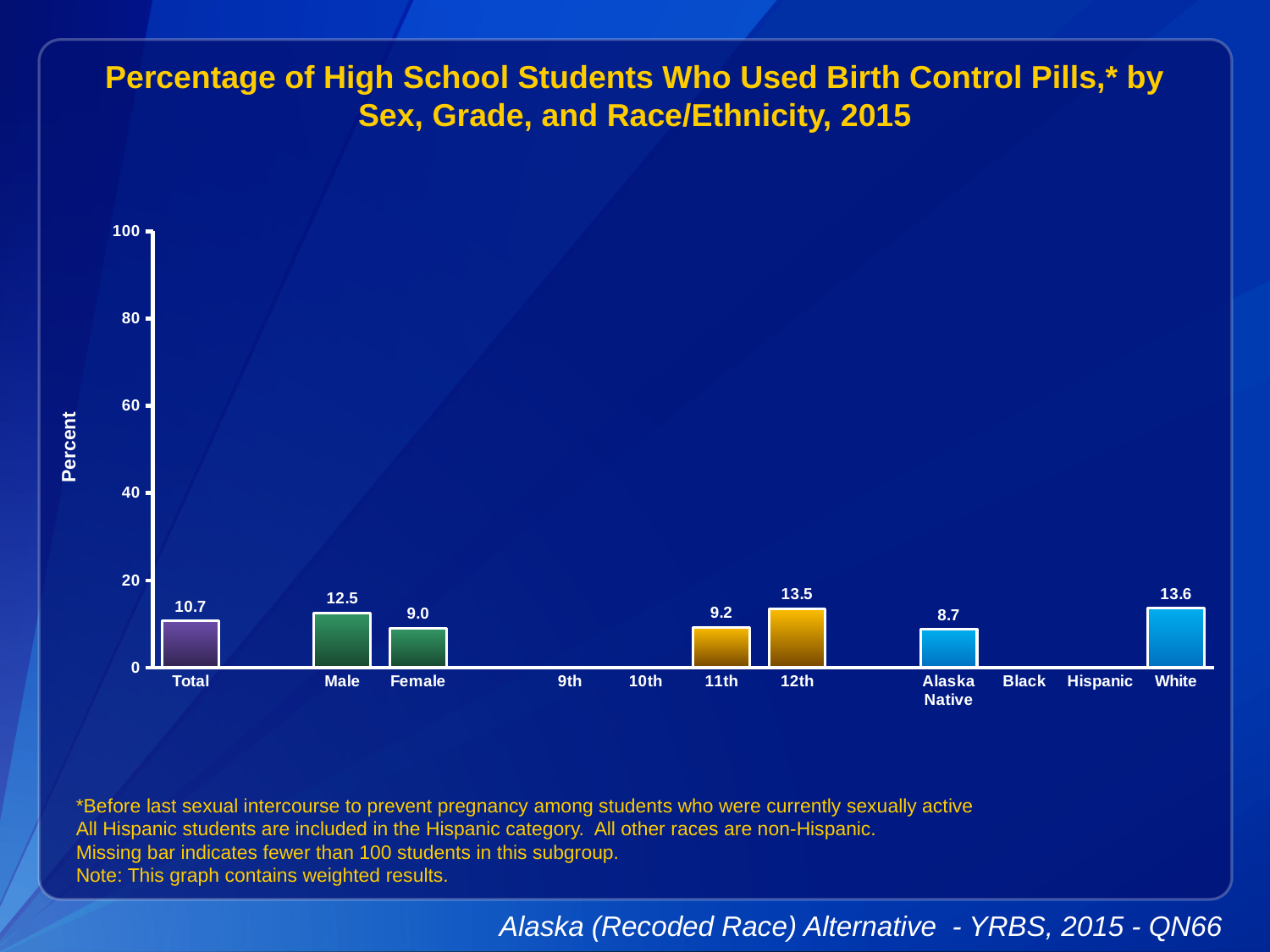
What kind of chart is shown on the slide? bar chart How many bars are plotted on the chart? 7 What is the difference between the values for Male and Female? 3.5 What is the value for White? 13.6 What is the value for Total? 10.7 Which is larger, the value for Male or the value for Female? Male Which is larger, the value for 11th grade or the value for 12th grade? 12th What is the value for Alaska Native? 8.7 Is the value for Total greater or less than 20? less What is the difference between the values for 12th grade and 11th grade? 4.3 What is the value for Male? 12.5 What is the value for 12th grade? 13.5